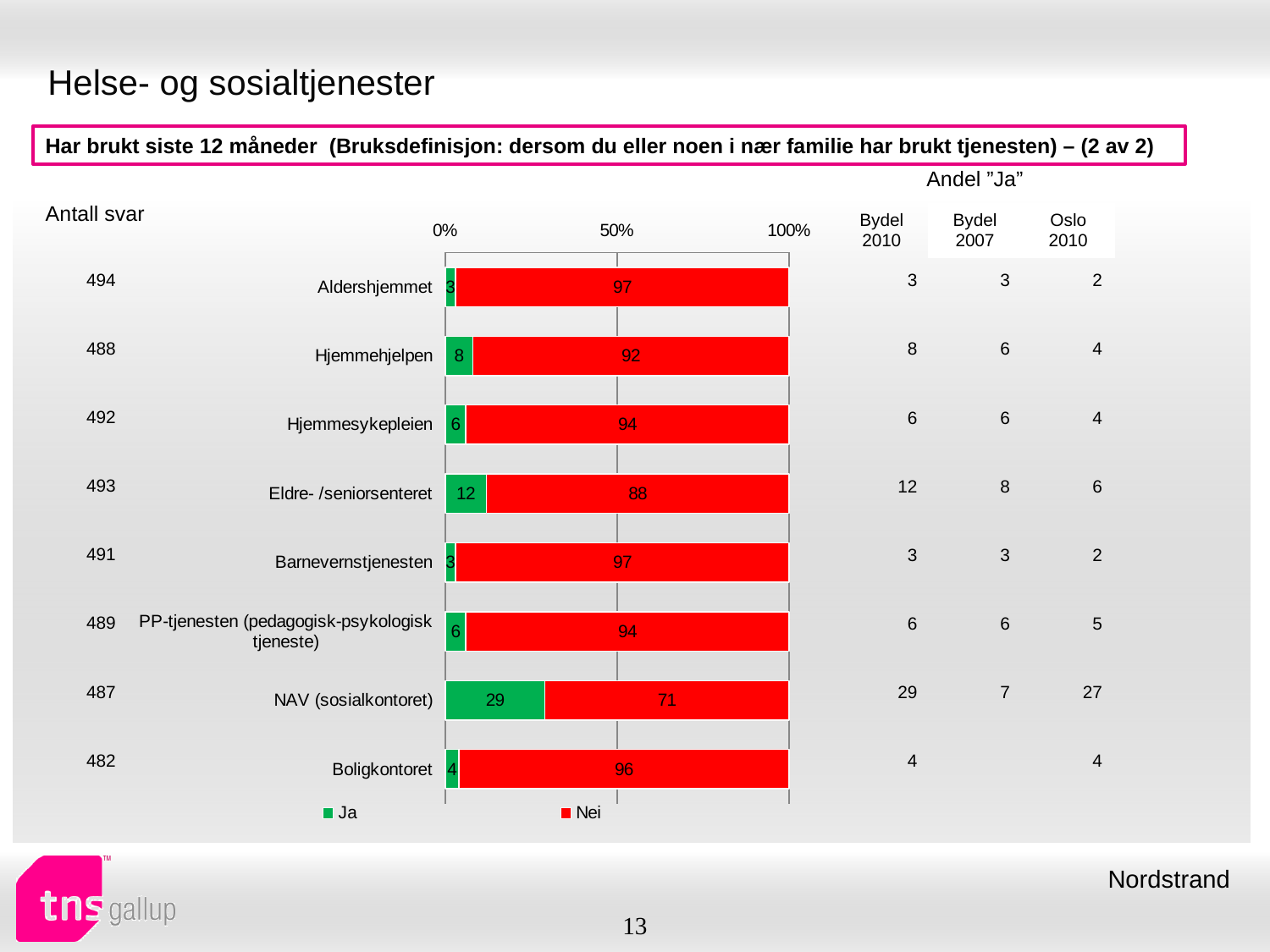
How many series does the legend list? 2 Which has a larger "Ja" value, Hjemmehjelpen or Hjemmesykepleien? Hjemmehjelpen Is the "Nei" value for Boligkontoret greater or less than 50%? greater What is the "Nei" value for Hjemmehjelpen? 92 What is the "Nei" value for NAV (sosialkontoret)? 71 Which category has the lowest "Nei" value? NAV (sosialkontoret) What is the difference between the "Ja" values for NAV (sosialkontoret) and Eldre- /seniorsenteret? 17 What kind of chart is shown on the slide? Stacked bar chart What are the two legend entries of the chart? Ja and Nei How many categories are shown in the chart? 8 What is the "Ja" value for Eldre- /seniorsenteret? 12 Which category has the highest "Ja" value? NAV (sosialkontoret)